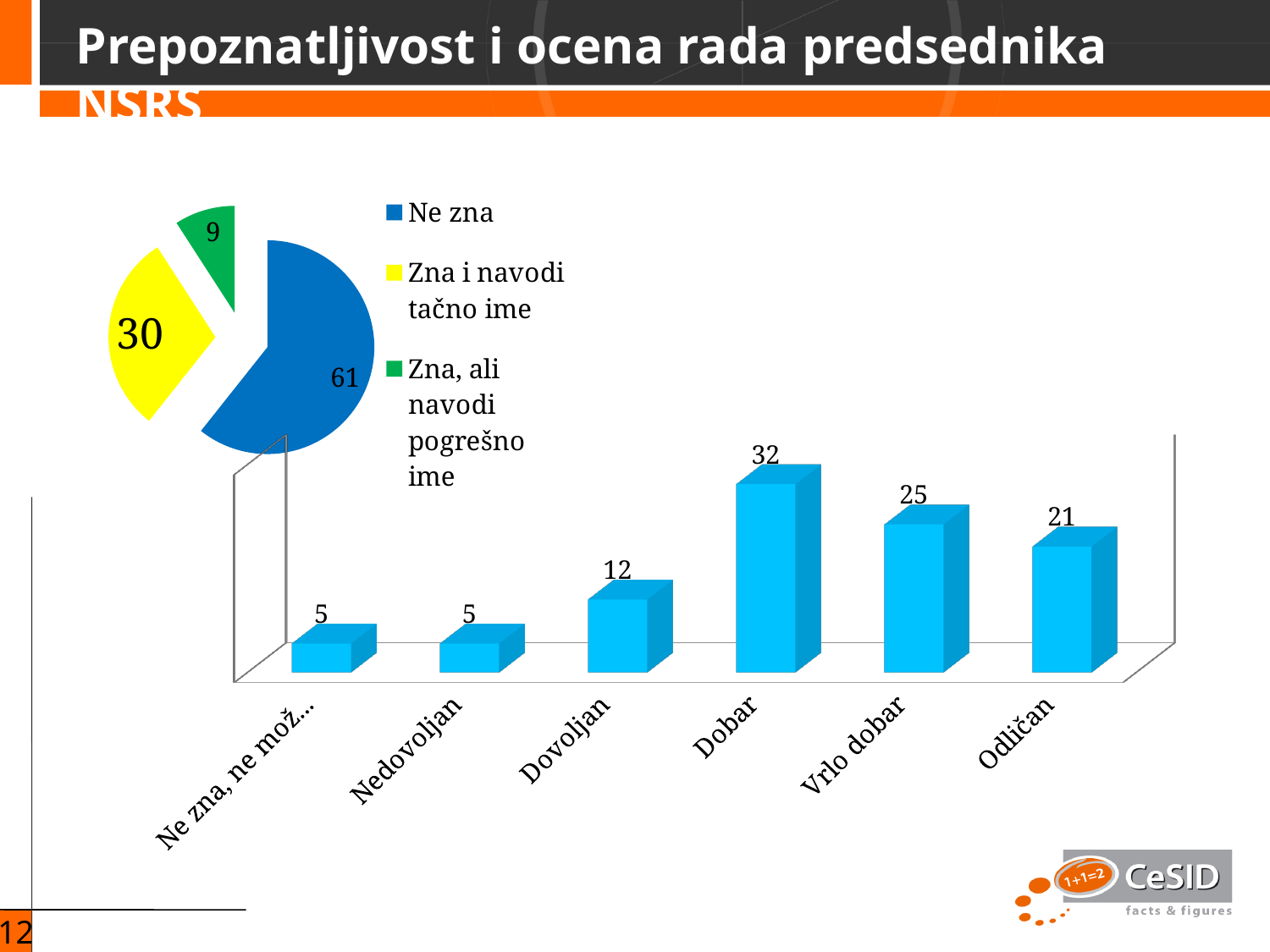
In the bar chart at the bottom, how many categories are shown? 6 In the bar chart at the bottom, what is the difference between the values for "Dobar" and "Vrlo dobar"? 7 In the pie chart, which slice is the smallest? Zna, ali navodi pogrešno ime In the bar chart at the bottom, what is the value for "Odličan"? 21 In the bar chart at the bottom, what is the value for "Dobar"? 32 In the pie chart, what value is shown for the "Ne zna" slice? 61 In the pie chart, how many entries does the legend list? 3 In the pie chart, what colour is the "Zna i navodi tačno ime" slice? Yellow In the bar chart at the bottom, which category has the highest value? Dobar In the pie chart, what value is shown for the "Zna i navodi tačno ime" slice? 30 In the bar chart at the bottom, which is larger, the value for "Dovoljan" or the value for "Nedovoljan"? Dovoljan What type of chart is the chart at the bottom of the slide? Bar chart